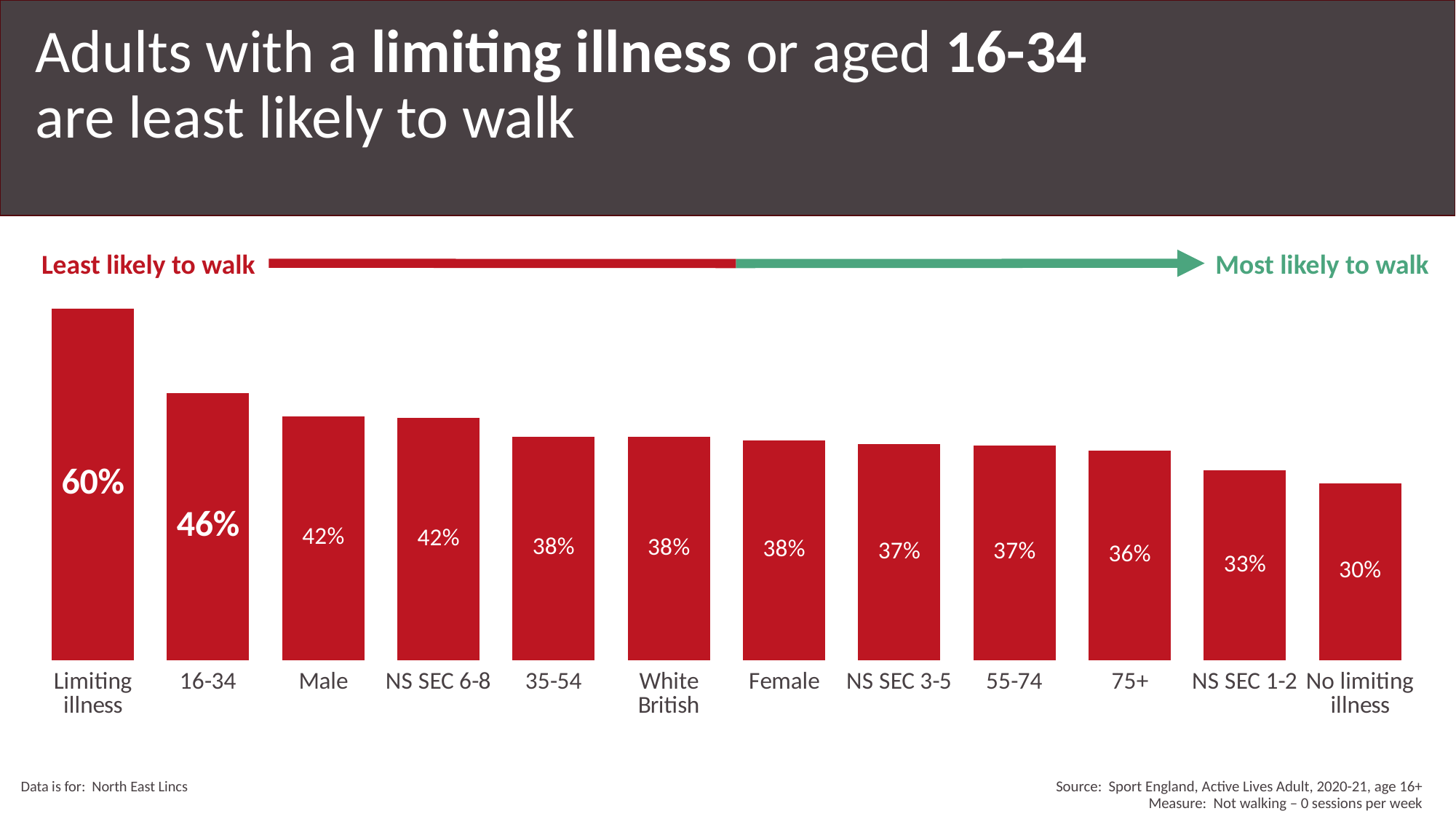
What is the difference between the values for Limiting illness and No limiting illness? 30% What is the value for NS SEC 1-2? 33% Which category has the lowest value? No limiting illness What is the value for Limiting illness? 60% Which category has the highest value? Limiting illness What is the value for 75+? 36% What is the value for 16-34? 46% How many categories are shown in the chart? 12 What is the difference between the values for 16-34 and 55-74? 9% Which is larger, the value for Male or the value for Female? Male What kind of chart is shown on the slide? Bar chart Do the values rise or fall from left to right along the x axis? Fall